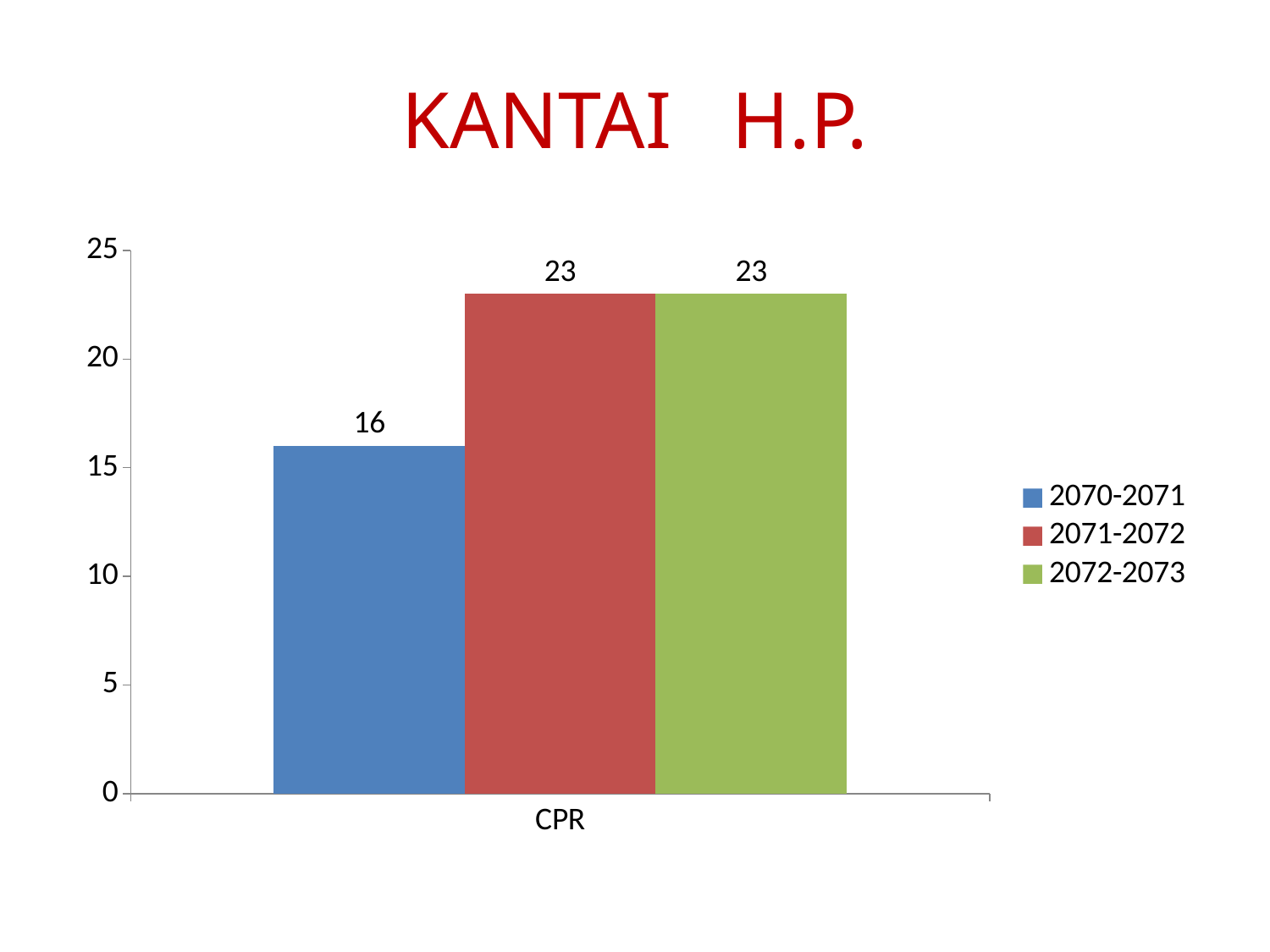
What is the title of the slide? KANTAI H.P. Is the CPR value for 2070-2071 greater or less than 20? less What is the CPR value for 2071-2072? 23 What is the difference between the CPR values for 2071-2072 and 2070-2071? 7 What is the CPR value for 2072-2073? 23 What is the CPR value for 2070-2071? 16 How many series does the legend list? 3 Which is larger, the CPR value for 2070-2071 or for 2072-2073? 2072-2073 Is the CPR value for 2071-2072 greater or less than 20? greater Which series has the lowest CPR value? 2070-2071 What is the category label on the x axis? CPR What kind of chart is shown on the slide? bar chart